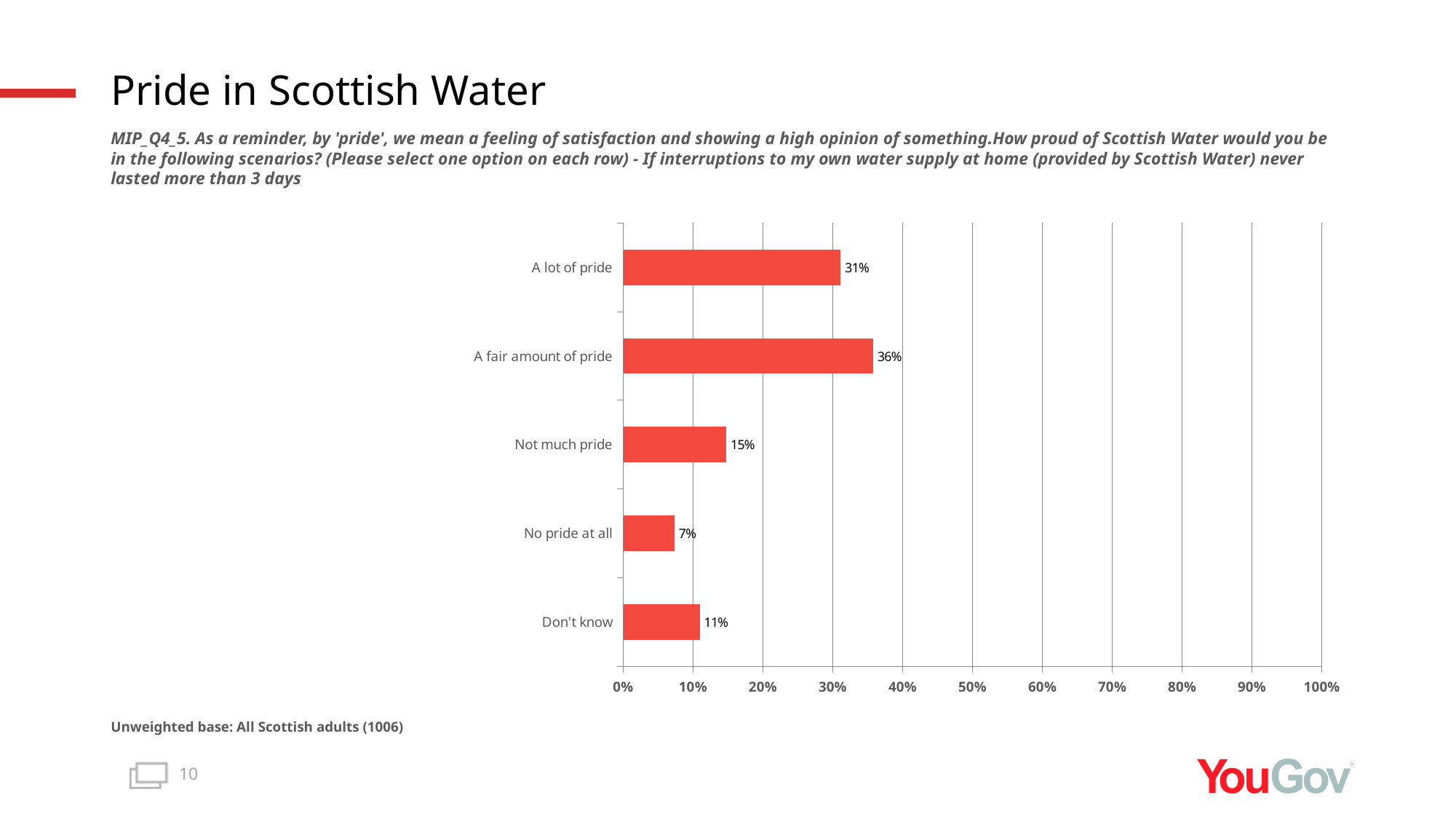
Is the value for 'A lot of pride' greater or less than 40%? less What is the value for 'A fair amount of pride'? 36% What percentage of respondents answered 'Not much pride'? 15% What kind of chart is shown on the slide? Bar chart Which category has the lowest value? No pride at all What percentage of respondents said they would feel 'A lot of pride'? 31% What is the difference between 'Not much pride' and 'No pride at all'? 8% Which category has the highest value? A fair amount of pride How many categories are shown in the chart? 5 What is the value for 'Don't know'? 11% Which is larger, the value for 'Don't know' or the value for 'No pride at all'? Don't know What is the difference between 'A fair amount of pride' and 'A lot of pride'? 5%